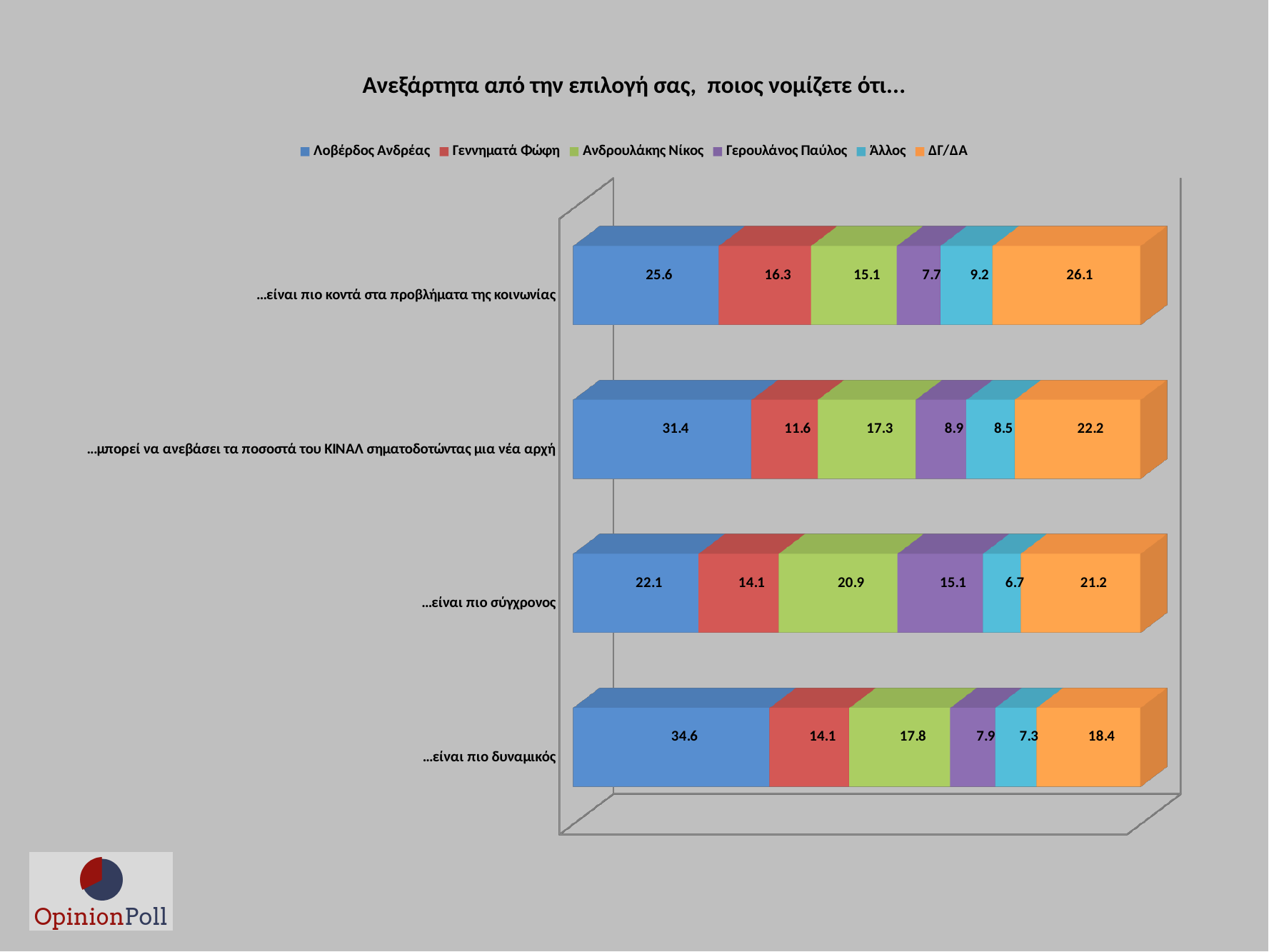
What is the difference between the values for Λοβέρδος Ανδρέας and Γεννηματά Φώφη in the category '...είναι πιο δυναμικός'? 20.5 What is the value for Γερουλάνος Παύλος in the category '...μπορεί να ανεβάσει τα ποσοστά του ΚΙΝΑΛ σηματοδοτώντας μια νέα αρχή'? 8.9 In the category '...είναι πιο σύγχρονος', which is larger: the value for Λοβέρδος Ανδρέας or the value for ΔΓ/ΔΑ? Λοβέρδος Ανδρέας What is the value for Ανδρουλάκης Νίκος in the category '...είναι πιο σύγχρονος'? 20.9 What is the value for ΔΓ/ΔΑ in the category '...είναι πιο κοντά στα προβλήματα της κοινωνίας'? 26.1 In which category does Άλλος have the lowest value? ...είναι πιο σύγχρονος What is the value for Λοβέρδος Ανδρέας in the category '...είναι πιο δυναμικός'? 34.6 How many series does the legend list? 6 What kind of chart is shown on the slide? Stacked bar chart In which category does Λοβέρδος Ανδρέας have the highest value? ...είναι πιο δυναμικός What is the title of the chart? Ανεξάρτητα από την επιλογή σας, ποιος νομίζετε ότι... How many categories (statements) are plotted on the chart? 4